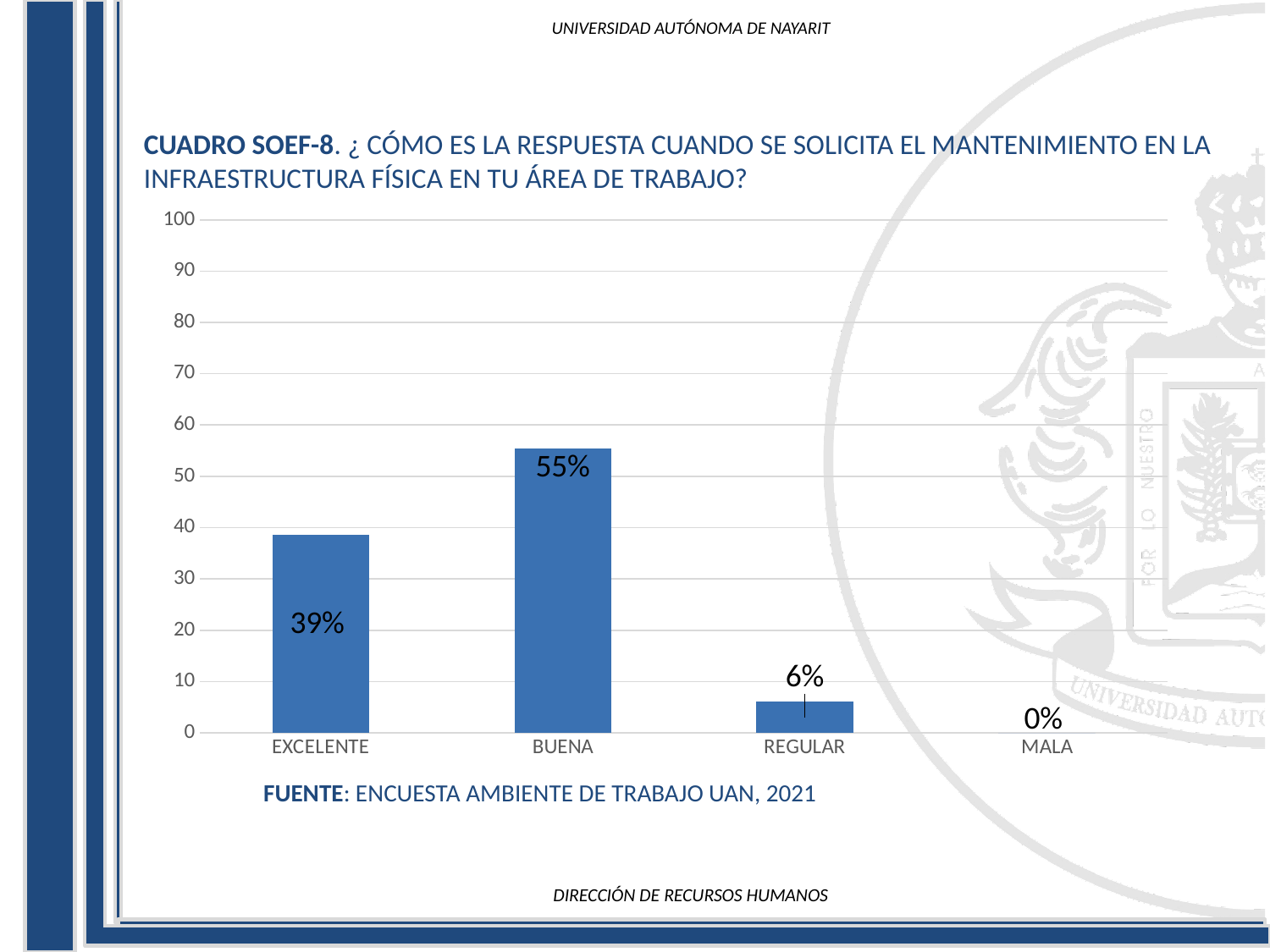
What is the difference between the values for BUENA and EXCELENTE? 16% Is the value for EXCELENTE greater or less than 30? greater Which is larger, the value for EXCELENTE or the value for REGULAR? EXCELENTE What is the value for REGULAR? 6% How many categories are shown on the x axis? 4 What source is cited below the chart? ENCUESTA AMBIENTE DE TRABAJO UAN, 2021 What is the value for BUENA? 55% What is the value for EXCELENTE? 39% What is the value for MALA? 0% Which category has the highest value? BUENA Which category has the lowest value? MALA What kind of chart is shown on the slide? Bar chart